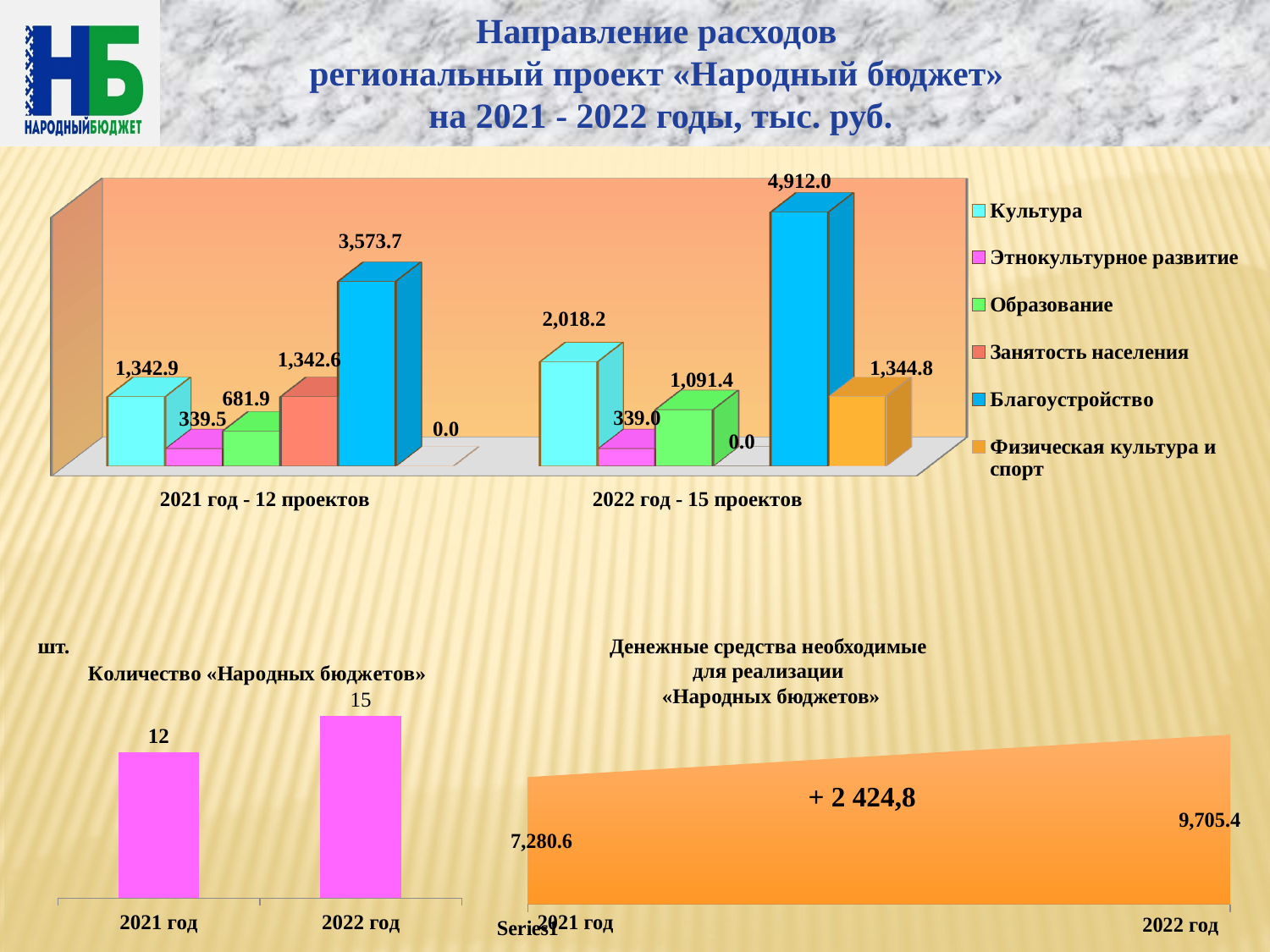
In the top chart, what is the value for Физическая культура и спорт in 2022 год? 1,344.8 How many series does the legend of the top chart list? 6 In the top chart, what is the difference between Культура in 2022 год and Культура in 2021 год? 675.3 In the chart titled «Количество «Народных бюджетов»», what is the difference between 2022 год and 2021 год? 3 In the bottom-right chart (Денежные средства необходимые для реализации «Народных бюджетов»), do the values rise or fall from 2021 год to 2022 год? rise In the top chart, what is the value for Образование in 2021 год? 681.9 In the top chart, which is larger: Образование in 2022 год or Занятость населения in 2021 год? Занятость населения in 2021 год In the top chart, which category has the highest value in 2021 год? Благоустройство In the top chart, what is the value for Благоустройство in 2022 год? 4,912.0 In the chart titled «Количество «Народных бюджетов»», what is the value for 2022 год? 15 In the bottom-right chart (Денежные средства необходимые для реализации «Народных бюджетов»), what is the value for 2021 год? 7,280.6 In the top chart, which category has the lowest value in 2022 год? Занятость населения